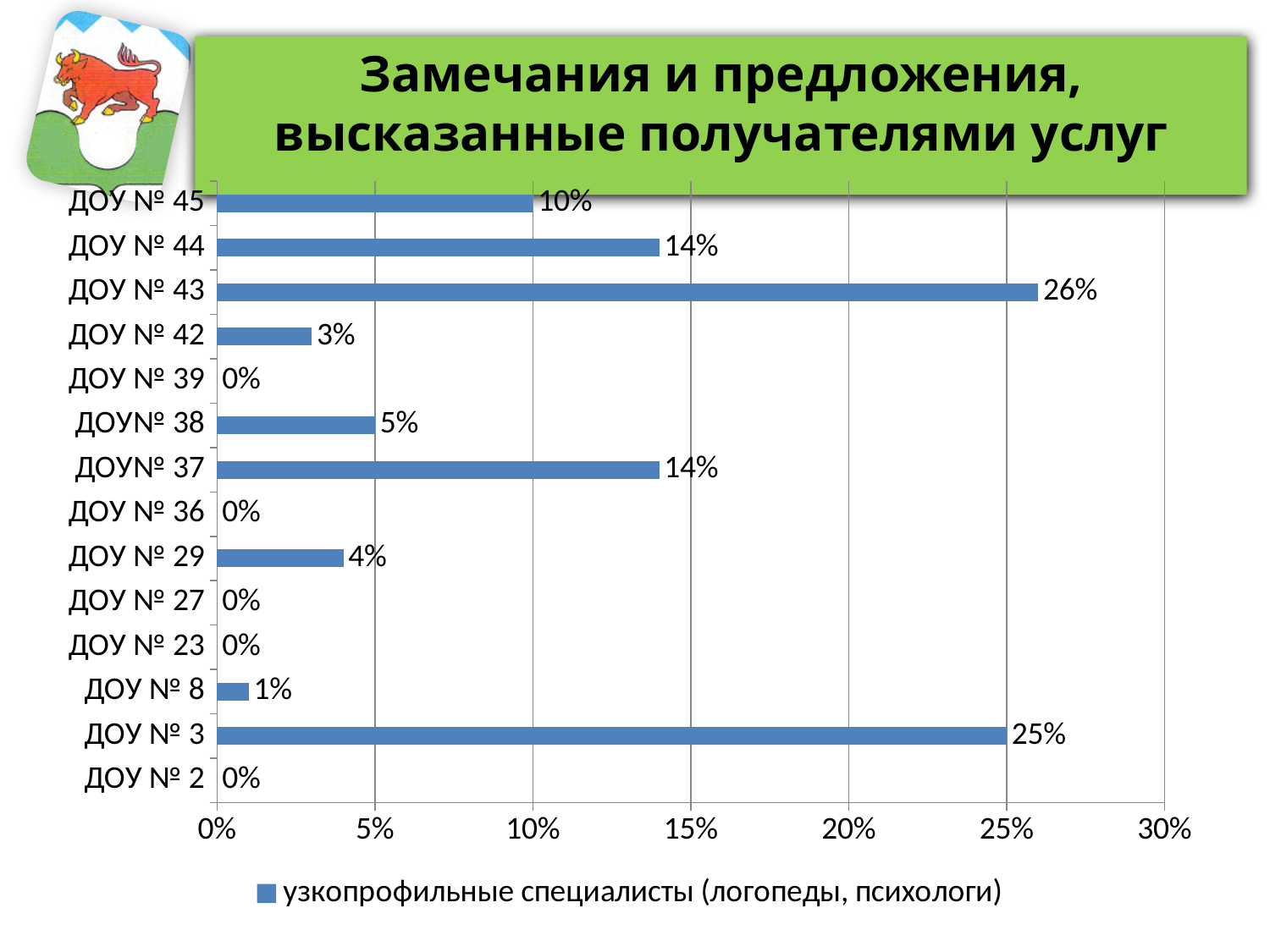
Which category has the highest value? ДОУ № 43 Which is larger, the value for ДОУ № 38 or the value for ДОУ № 29? ДОУ № 38 What is the value for ДОУ № 42? 3% How many categories have a value of 0%? 5 What kind of chart is shown on the slide? Bar chart How many categories are shown on the chart? 14 What is the difference between the values for ДОУ № 43 and ДОУ № 3? 1% What is the value for ДОУ № 3? 25% How many series does the legend list? 1 What is the series name shown in the legend? узкопрофильные специалисты (логопеды, психологи) What is the difference between the values for ДОУ № 44 and ДОУ № 45? 4% What is the value for ДОУ № 43? 26%